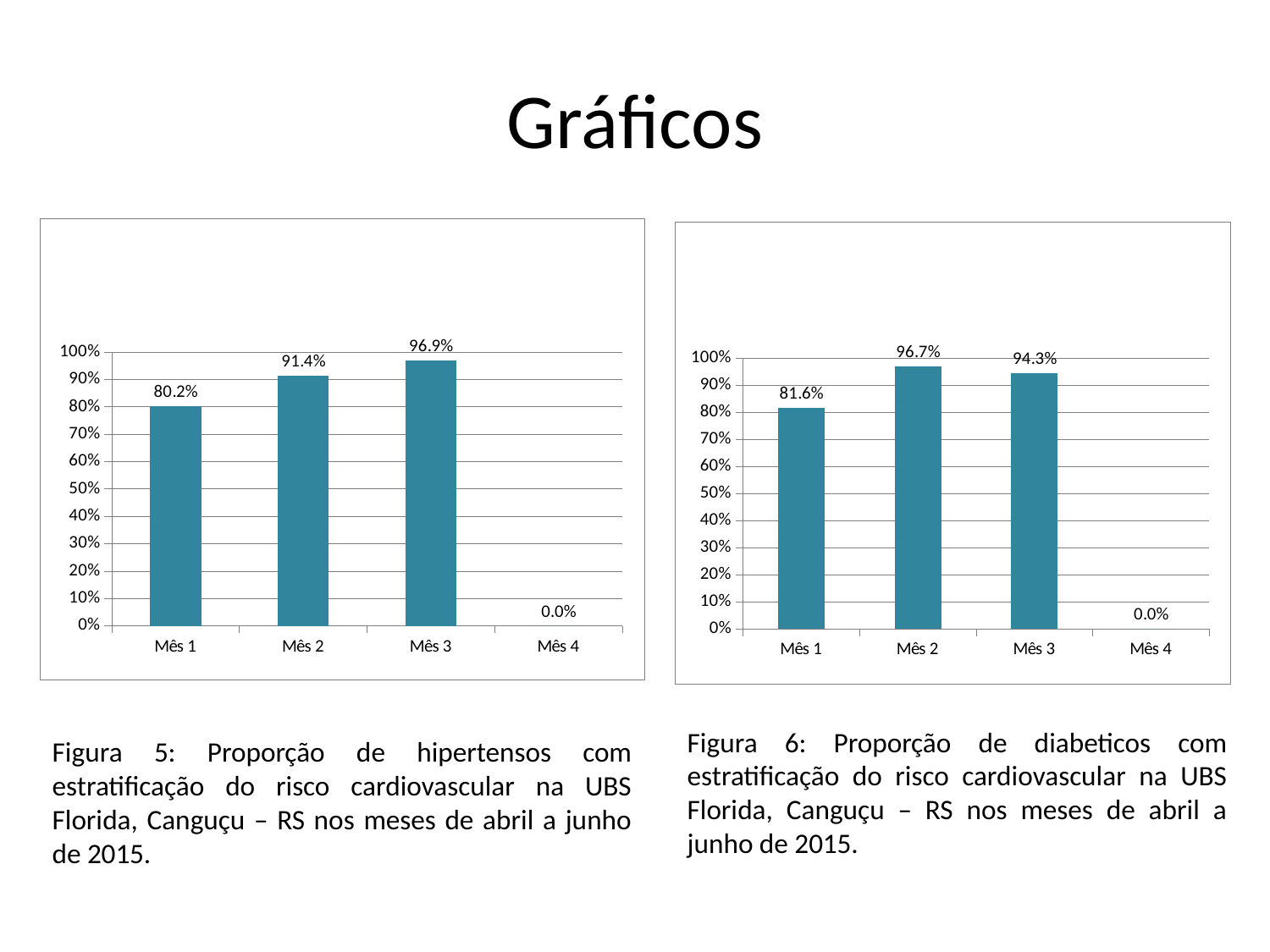
In the right chart (Figura 6), which month has the lowest value? Mês 4 In the left chart (Figura 5), what is the value for Mês 1? 80.2% In the right chart (Figura 6), which month has the highest value? Mês 2 In the right chart (Figura 6), which is larger, the value for Mês 1 or the value for Mês 3? Mês 3 In the right chart (Figura 6), what is the value for Mês 2? 96.7% How many categories are shown on the x axis of the left chart (Figura 5)? 4 In the left chart (Figura 5), which month has the highest value? Mês 3 In the right chart (Figura 6), what is the value for Mês 4? 0.0% In the left chart (Figura 5), what is the difference between the values for Mês 2 and Mês 1? 11.2% In the right chart (Figura 6), what is the difference between the values for Mês 2 and Mês 3? 2.4% In the left chart (Figura 5), what is the value for Mês 3? 96.9% What kind of chart is the right chart (Figura 6)? Bar chart